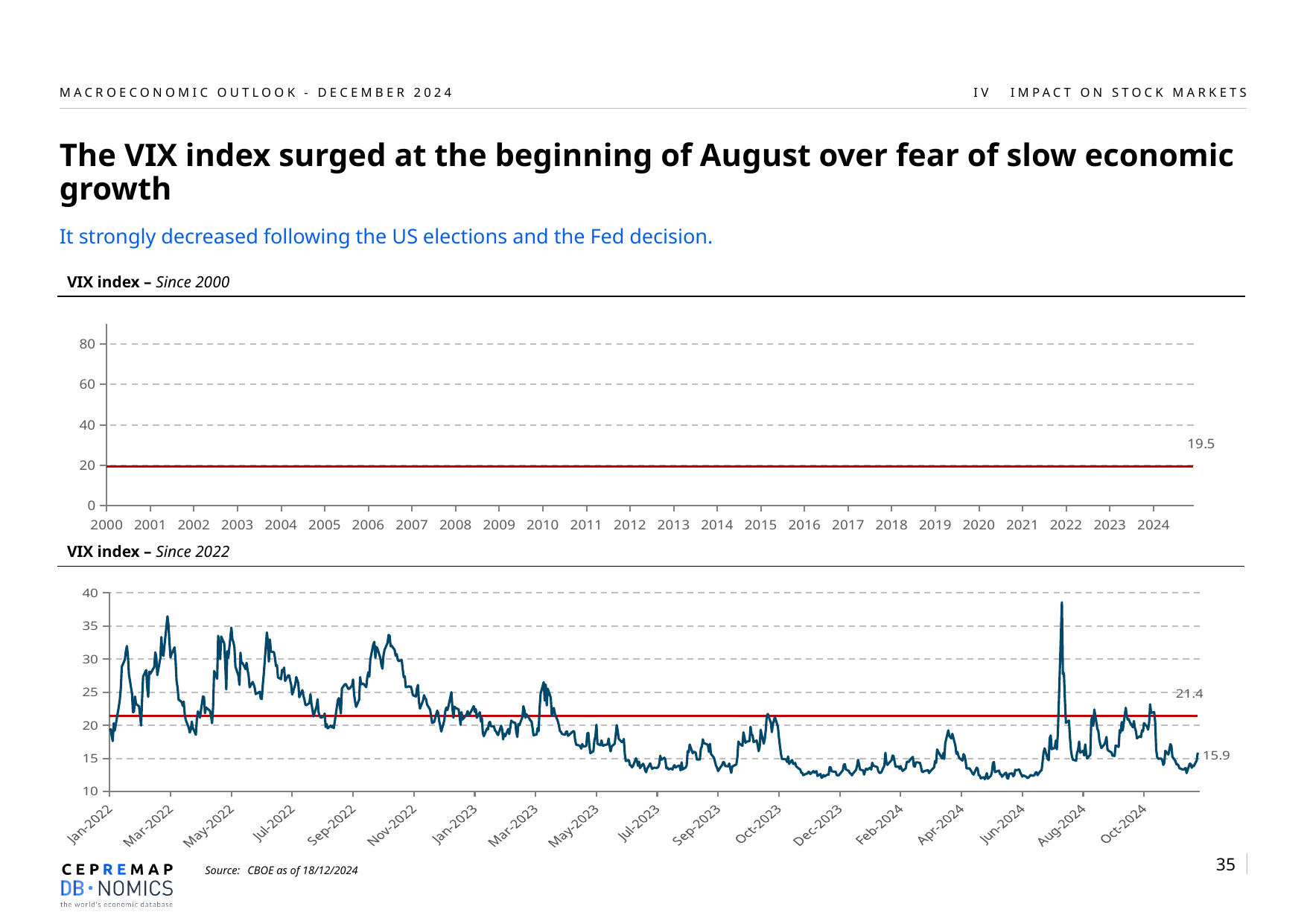
What is the highest value shown on the y axis of the 'VIX index – Since 2000' chart? 80 In the 'VIX index – Since 2022' chart, is the value around July 2023 greater or less than 20? less In the 'VIX index – Since 2022' chart, is the value at the start of January 2022 greater or less than 20? less In the 'VIX index – Since 2022' chart, is the final labelled value (15.9) larger or smaller than the red line value (21.4)? smaller In the 'VIX index – Since 2022' chart, what value is labelled at the end of the series? 15.9 In the 'VIX index – Since 2022' chart, does the VIX overall rise or fall from January 2022 to the end of 2024? fall In the 'VIX index – Since 2022' chart, what is the difference between the red line value and the final labelled value? 5.5 What is the source cited for the charts on the slide? CBOE as of 18/12/2024 In the 'VIX index – Since 2022' chart, what value is labelled on the red horizontal line? 21.4 In the 'VIX index – Since 2022' chart, is the peak value in early August 2024 greater or less than 35? greater In the 'VIX index – Since 2000' chart, what value is labelled on the red horizontal line? 19.5 What kind of chart is the 'VIX index – Since 2022' chart? line chart